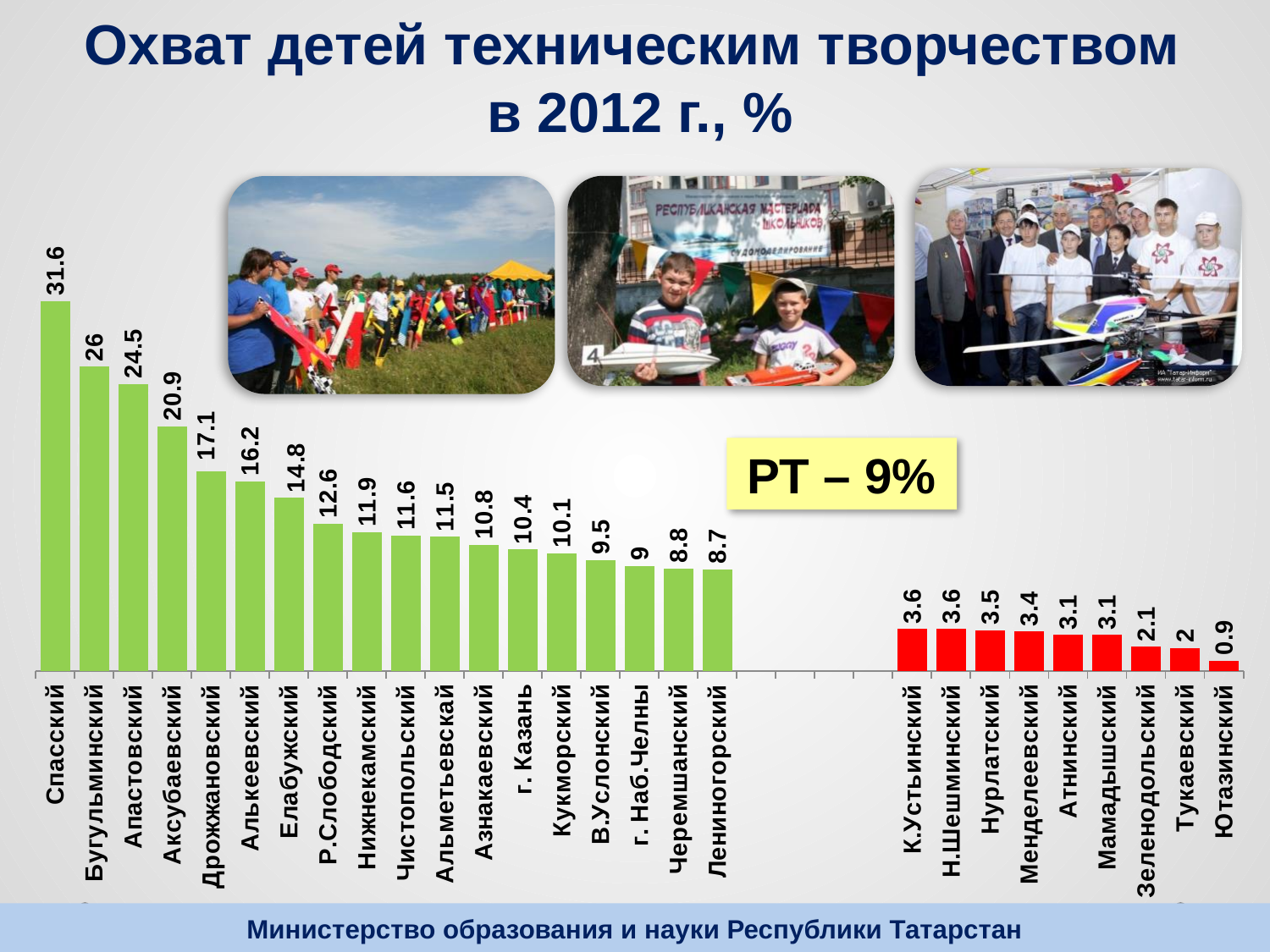
How many red bars are shown in the chart? 9 Which category has the highest value? Спасский What is the value for г. Казань? 10.4 What kind of chart is shown on the slide? Bar chart What is the value for Зеленодольский? 2.1 How many categories are shown in the chart? 27 Which is larger, the value for Елабужский or the value for Нижнекамский? Елабужский What is the value for Спасский? 31.6 Which category has the lowest value? Ютазинский What is the value for Ютазинский? 0.9 What value is shown for РТ in the yellow box? 9% What is the difference between the values for Спасский and Бугульминский? 5.6